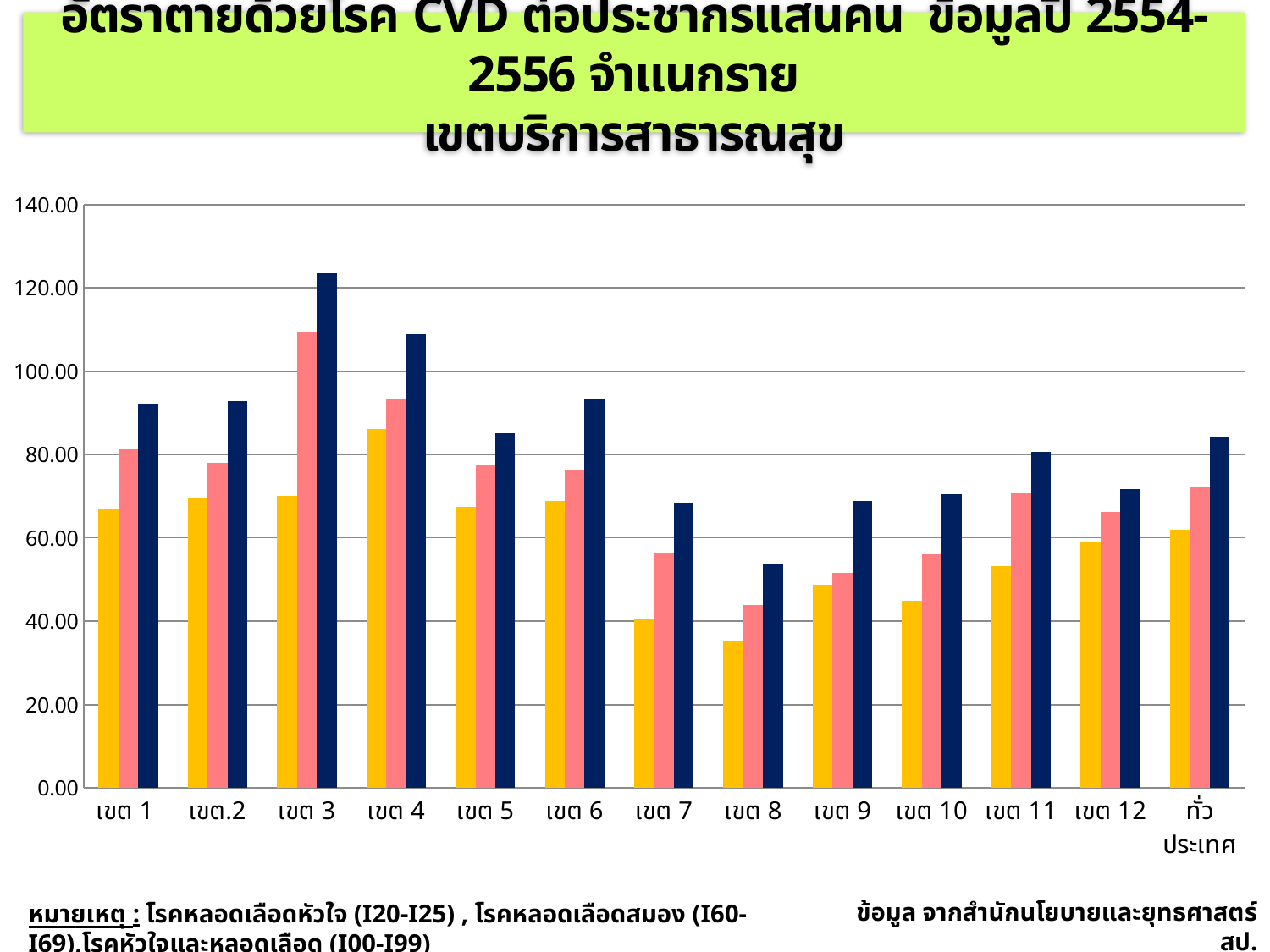
Is the value of the yellow bar for เขต 4 greater or less than 80? greater Which category has the shortest bar in the chart? เขต 8 Is the value of the yellow bar for เขต 8 greater or less than 40? less What is the highest value shown on the y axis of the chart? 140.00 From เขต 6 to เขต 8, do the yellow bars rise or fall? fall Is the value of the dark blue bar for เขต 8 greater or less than 60? less Which is larger: the dark blue bar for เขต 3 or the dark blue bar for เขต 4? เขต 3 How many categories are shown along the x axis of the chart? 13 Which is larger: the yellow bar for เขต 4 or the yellow bar for เขต 3? เขต 4 Which category has the tallest bar in the chart? เขต 3 What kind of chart is shown on the slide? bar chart